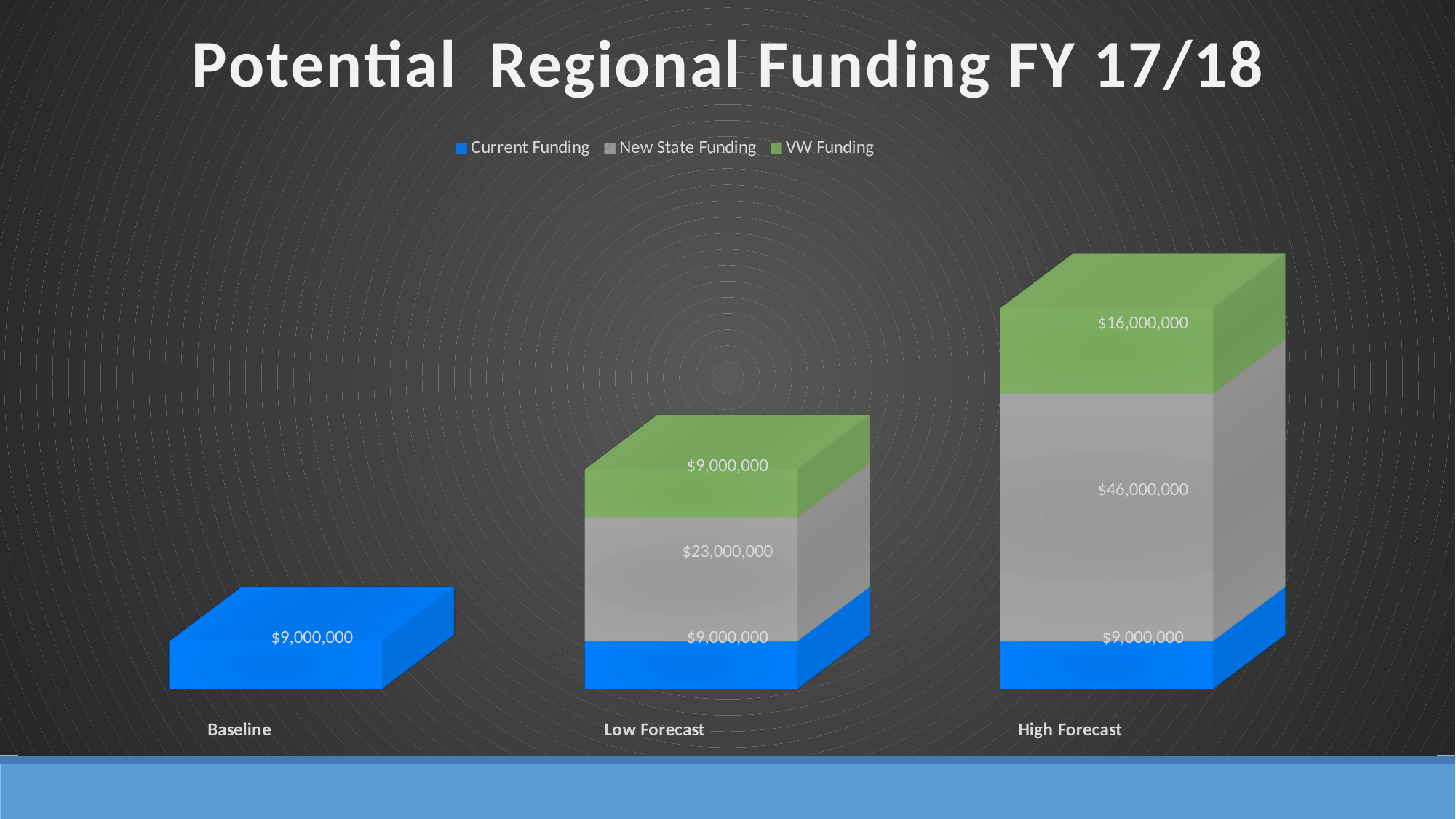
Which category has the highest total funding? High Forecast What is the New State Funding value for Low Forecast? $23,000,000 What is the difference between New State Funding for High Forecast and Low Forecast? $23,000,000 What is the Current Funding value for Baseline? $9,000,000 What is the New State Funding value for High Forecast? $46,000,000 Which category has the lowest total funding? Baseline What is the VW Funding value for High Forecast? $16,000,000 What is the total funding for the High Forecast bar? $71,000,000 What kind of chart is shown on the slide? Stacked bar chart What is the total funding for the Low Forecast bar? $41,000,000 What is the VW Funding value for Low Forecast? $9,000,000 How many series does the legend list? 3